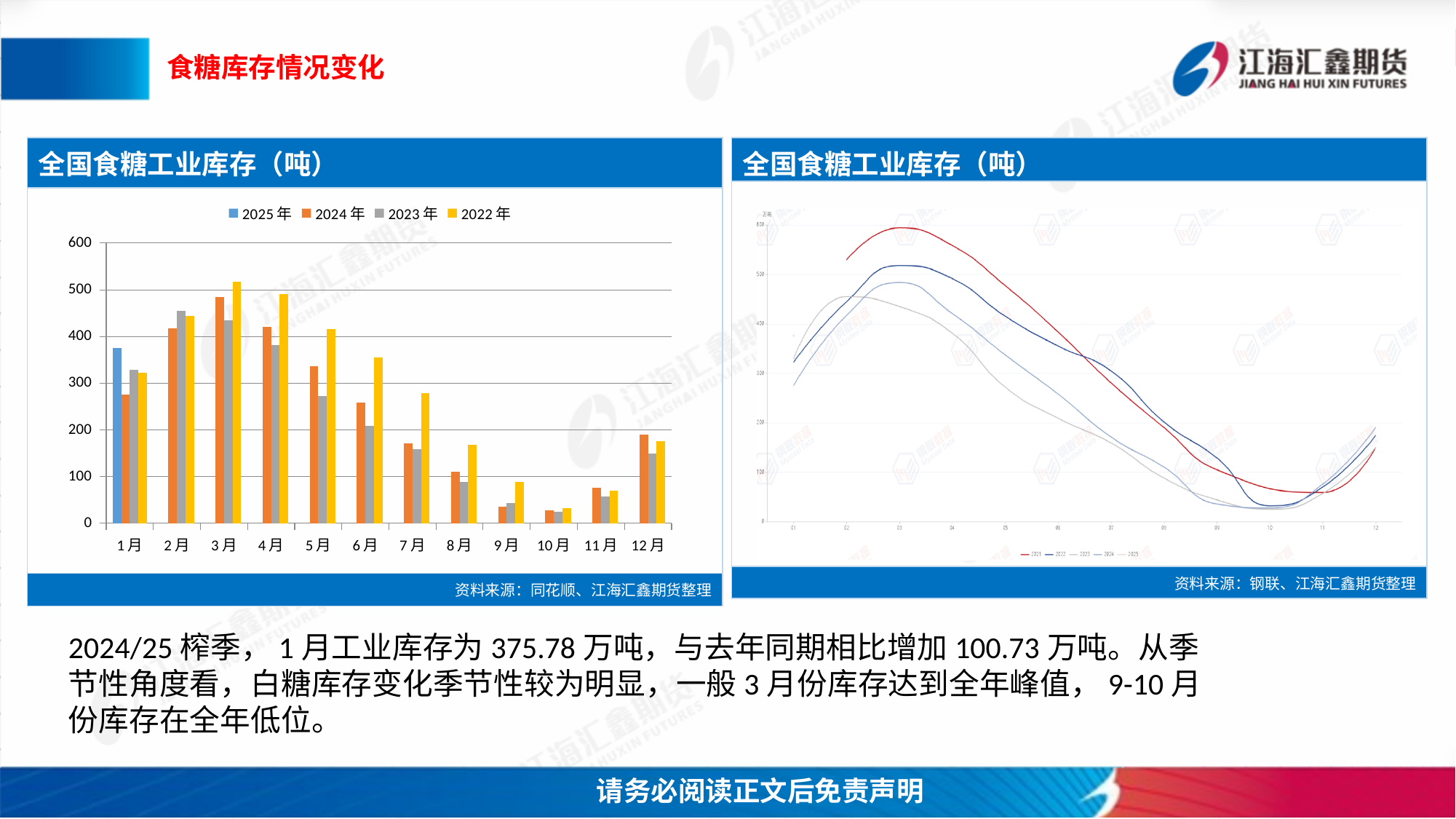
In the left bar chart, which month has the highest 2022年 bar? 3月 What kind of chart is the right chart titled 全国食糖工业库存（吨）? line chart What kind of chart is the left chart titled 全国食糖工业库存（吨）? bar chart In the left bar chart, which month has the lowest 2022年 bar? 10月 In the left bar chart, do the 2022年 values rise or fall from 3月 to 10月? fall In the left bar chart, which year has the tallest bar in 1月? 2025年 In the left bar chart, how many series does the legend list? 4 In the left bar chart, is the value for 2022年 in 10月 greater or less than 100? less In the left bar chart, is the value for 2022年 in 3月 greater or less than 500? greater In the left bar chart, how many month categories are shown on the x axis? 12 In the left bar chart, in 5月, which is larger: the 2024年 bar or the 2023年 bar? 2024年 In the left bar chart, is the value for 2025年 in 1月 greater or less than 300? greater